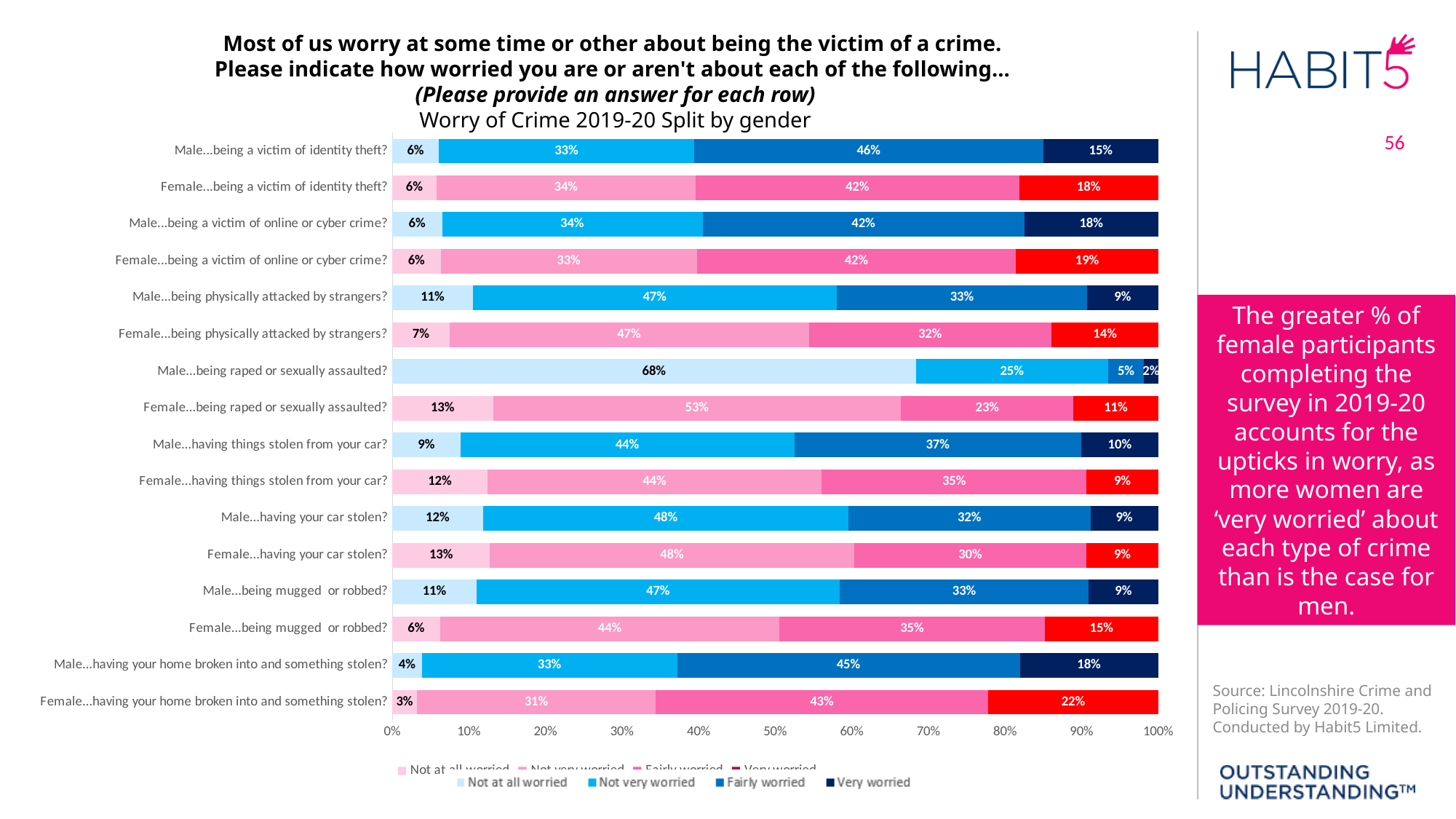
How many series does the legend list? 4 Which row has the lowest 'Very worried' percentage? Male...being raped or sexually assaulted? What type of chart is shown on the slide? Stacked bar chart What is the difference in the 'Not at all worried' percentage between males and females for being raped or sexually assaulted? 55 percentage points What is the difference in the 'Very worried' percentage between females and males for being mugged or robbed? 6 percentage points Which row has the highest 'Very worried' percentage? Female...having your home broken into and something stolen? What is the title of the chart? Worry of Crime 2019-20 Split by gender What percentage of female respondents are 'Very worried' about having their home broken into and something stolen? 22% How many rows (categories) are plotted in the chart? 16 What percentage of female respondents are 'Not very worried' about being raped or sexually assaulted? 53% For being a victim of identity theft, which group has the larger 'Fairly worried' percentage, males or females? Males What percentage of male respondents are 'Not at all worried' about being raped or sexually assaulted? 68%